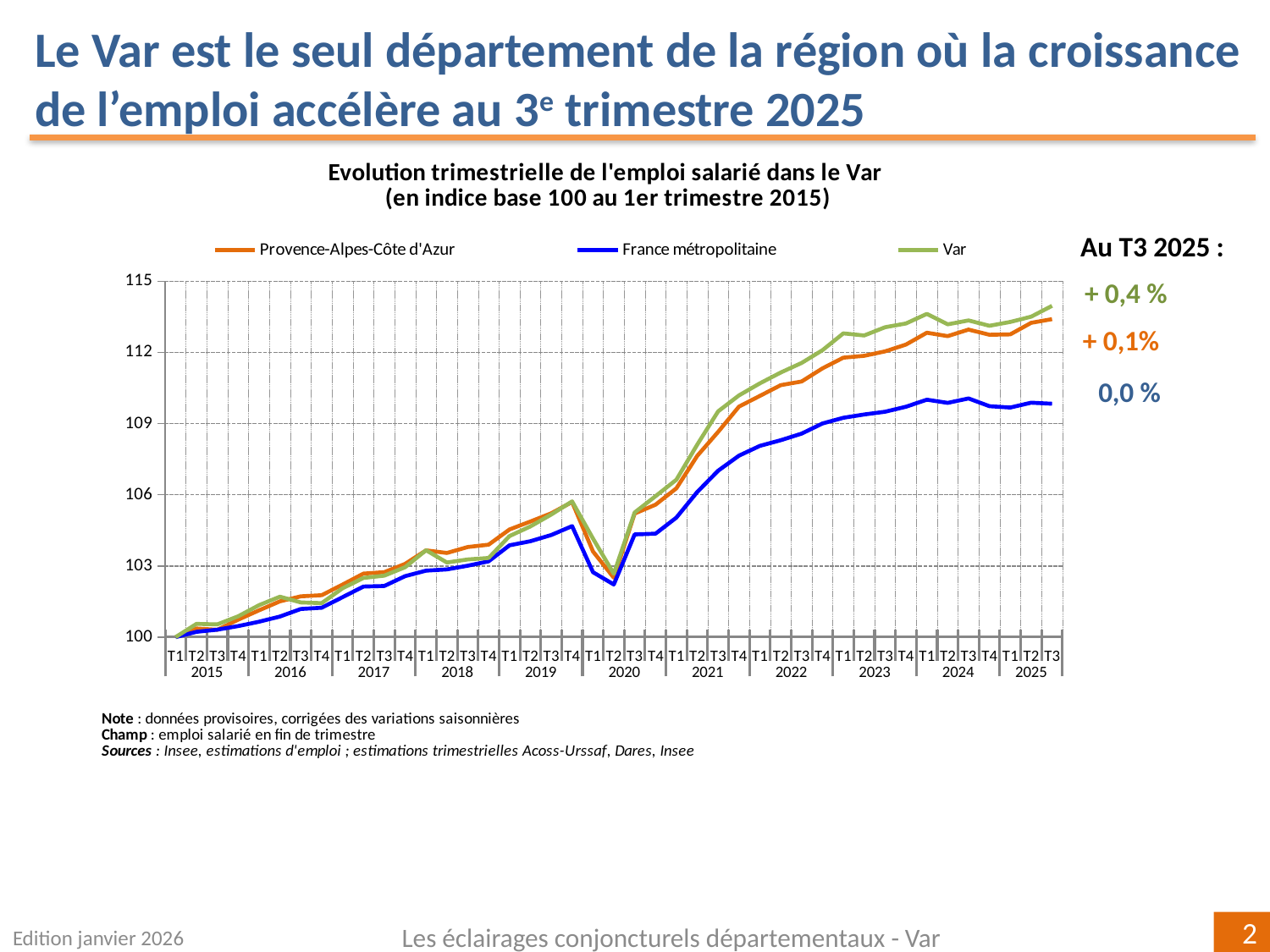
What is the title of the chart? Evolution trimestrielle de l'emploi salarié dans le Var (en indice base 100 au 1er trimestre 2015) What kind of chart is shown on the slide? line chart According to the annotation, what is the change for Var at T3 2025? + 0,4 % Which series has the lowest index value at T3 2025? France métropolitaine According to the annotation, what is the change for France métropolitaine at T3 2025? 0,0 % Is the value for France métropolitaine at T2 2020 greater or less than 103? less Which series are listed in the legend? Provence-Alpes-Côte d'Azur, France métropolitaine, Var Which series has the highest index value at T3 2025? Var What is the index value of all three series at T1 2015? 100 Overall, do the index values rise or fall from 2015 to 2025? rise Is the value for Var at T1 2024 greater or less than 112? greater How many series does the legend list? 3